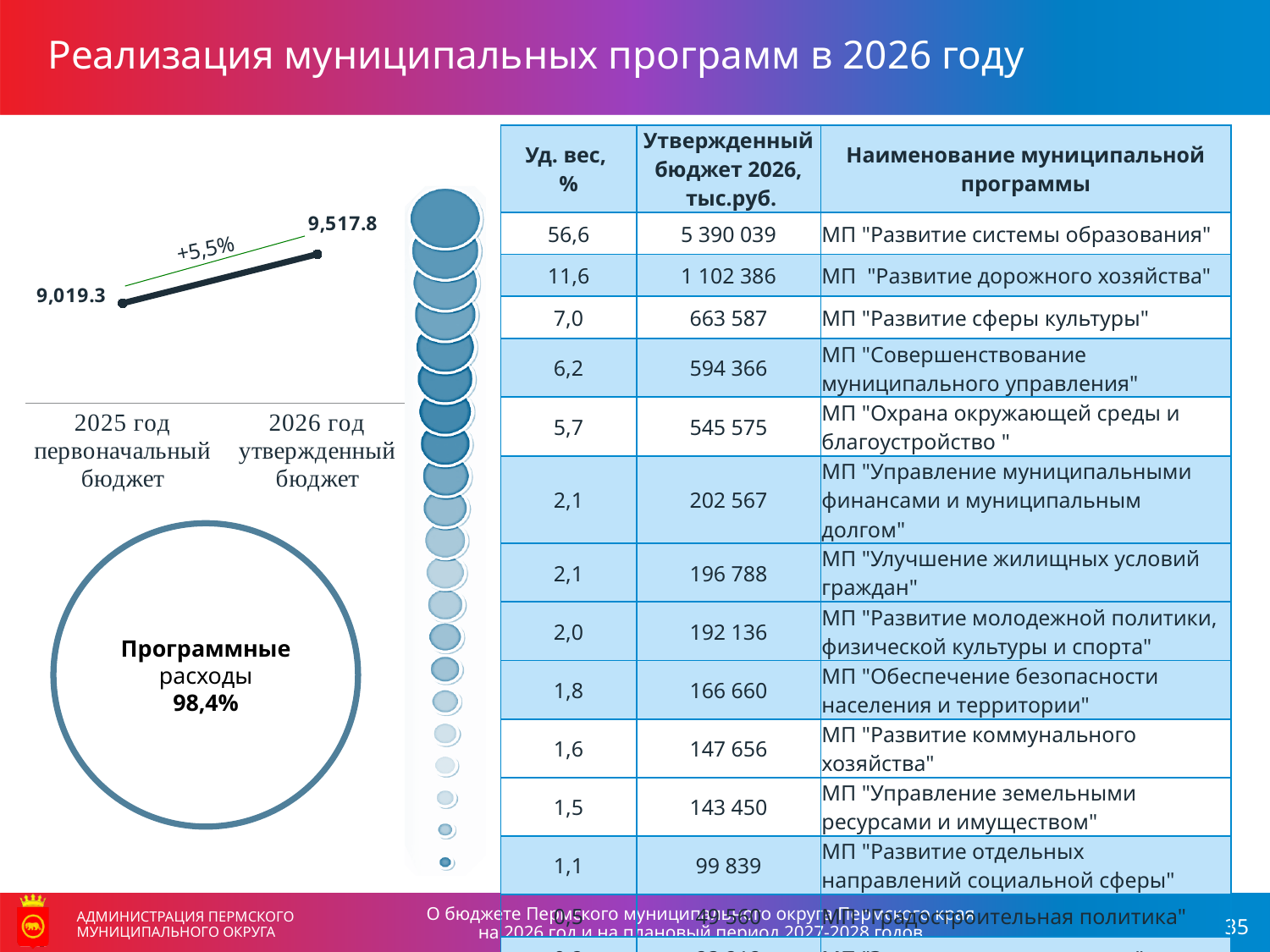
On the line chart, which of the two points is higher: 2025 год первоначальный бюджет or 2026 год утвержденный бюджет? 2026 год утвержденный бюджет What percentage is shown inside the circle labelled Программные расходы? 98,4% On the line chart, what is the difference between the 2026 год утвержденный бюджет value and the 2025 год первоначальный бюджет value? 498.5 On the line chart, what is the value for 2026 год утвержденный бюджет? 9,517.8 What percentage change is labelled on the line chart between the two points? +5,5% On the line chart, which category has the highest value? 2026 год утвержденный бюджет On the line chart, which category has the lowest value? 2025 год первоначальный бюджет On the line chart, does the value rise or fall from 2025 год первоначальный бюджет to 2026 год утвержденный бюджет? rise How many data points are plotted on the line chart? 2 What kind of chart shows the 2025 and 2026 budget values? line chart On the line chart, what is the value for 2025 год первоначальный бюджет? 9,019.3